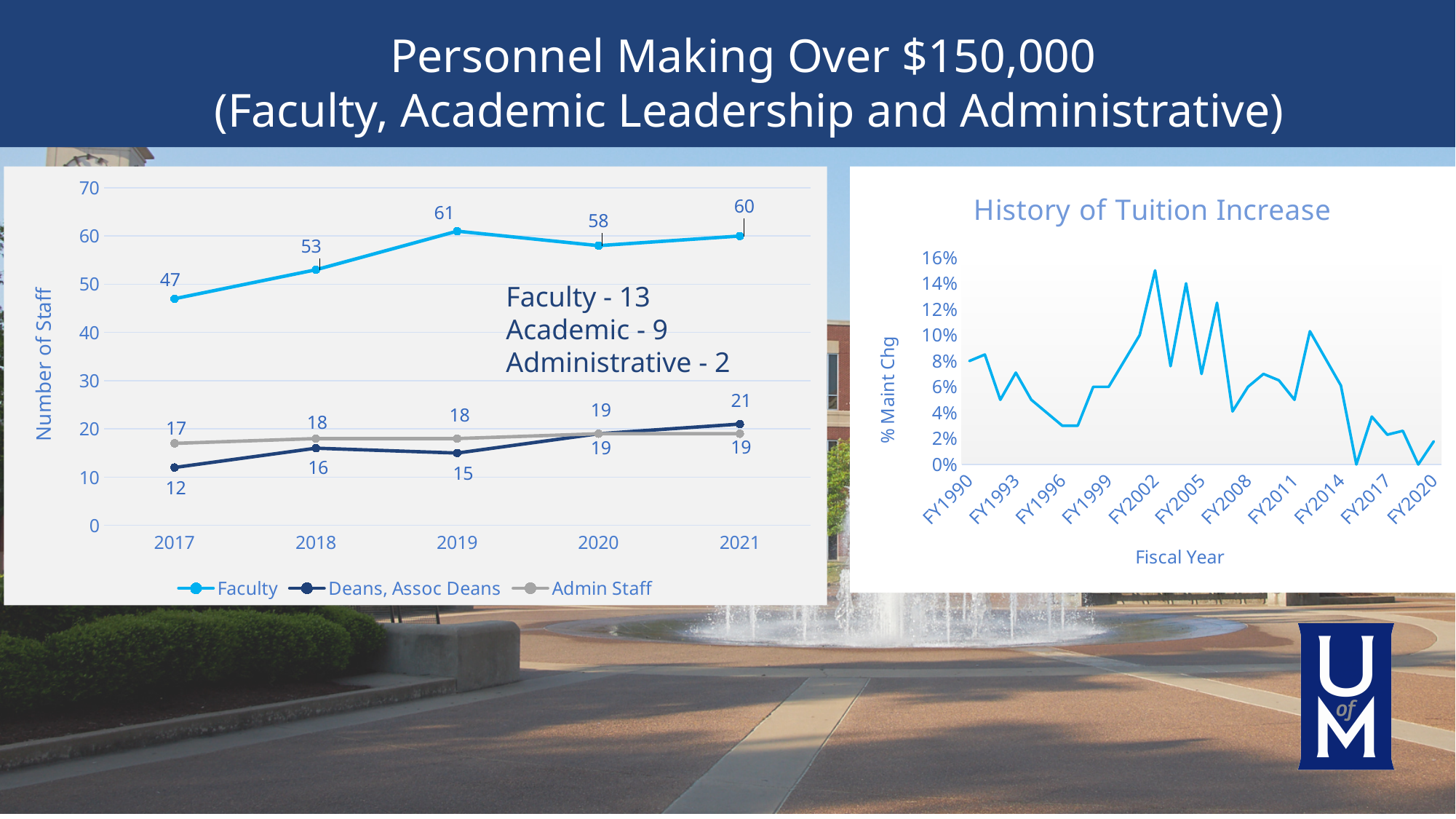
On the History of Tuition Increase chart, is the value for FY2020 greater or less than 4%? less On the left chart, in which year was the Faculty value highest? 2019 On the left chart, what was the number of Admin Staff in 2021? 19 On the left chart, what was the number of Faculty staff in 2019? 61 On the left chart, how many series does the legend list? 3 On the left chart, in which year was the Deans, Assoc Deans value lowest? 2017 What is the x-axis label of the History of Tuition Increase chart? Fiscal Year On the left chart, how many years are shown on the x axis? 5 What kind of chart is the History of Tuition Increase chart? line chart On the left chart, what is the difference between the Faculty values in 2021 and 2017? 13 On the left chart, which is larger in 2021: Deans, Assoc Deans or Admin Staff? Deans, Assoc Deans On the left chart, what was the number of Deans, Assoc Deans in 2017? 12